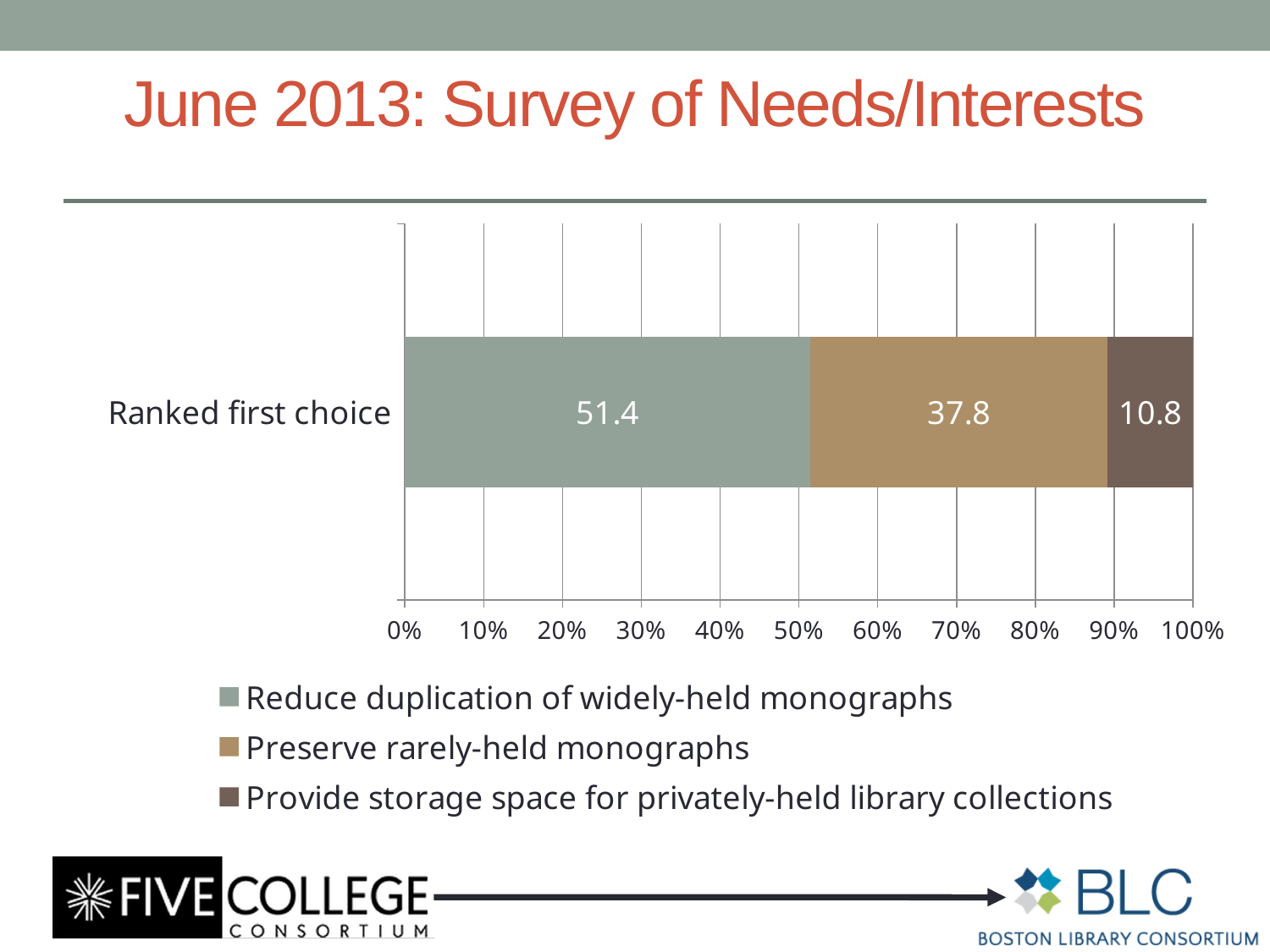
What value is shown for "Provide storage space for privately-held library collections" in the Ranked first choice bar? 10.8 Which series has the smallest value in the Ranked first choice bar? Provide storage space for privately-held library collections What is the difference between the values for "Reduce duplication of widely-held monographs" and "Preserve rarely-held monographs"? 13.6 Which is larger: the value for "Preserve rarely-held monographs" or the value for "Provide storage space for privately-held library collections"? Preserve rarely-held monographs What value is shown for "Reduce duplication of widely-held monographs" in the Ranked first choice bar? 51.4 What is the title of the slide containing the chart? June 2013: Survey of Needs/Interests Which series has the largest value in the Ranked first choice bar? Reduce duplication of widely-held monographs What value is shown for "Preserve rarely-held monographs" in the Ranked first choice bar? 37.8 Is the value for "Reduce duplication of widely-held monographs" greater or less than 50%? greater What is the total of the three segments in the Ranked first choice bar? 100 What kind of chart is shown on the slide? Stacked bar chart How many series does the legend list? 3